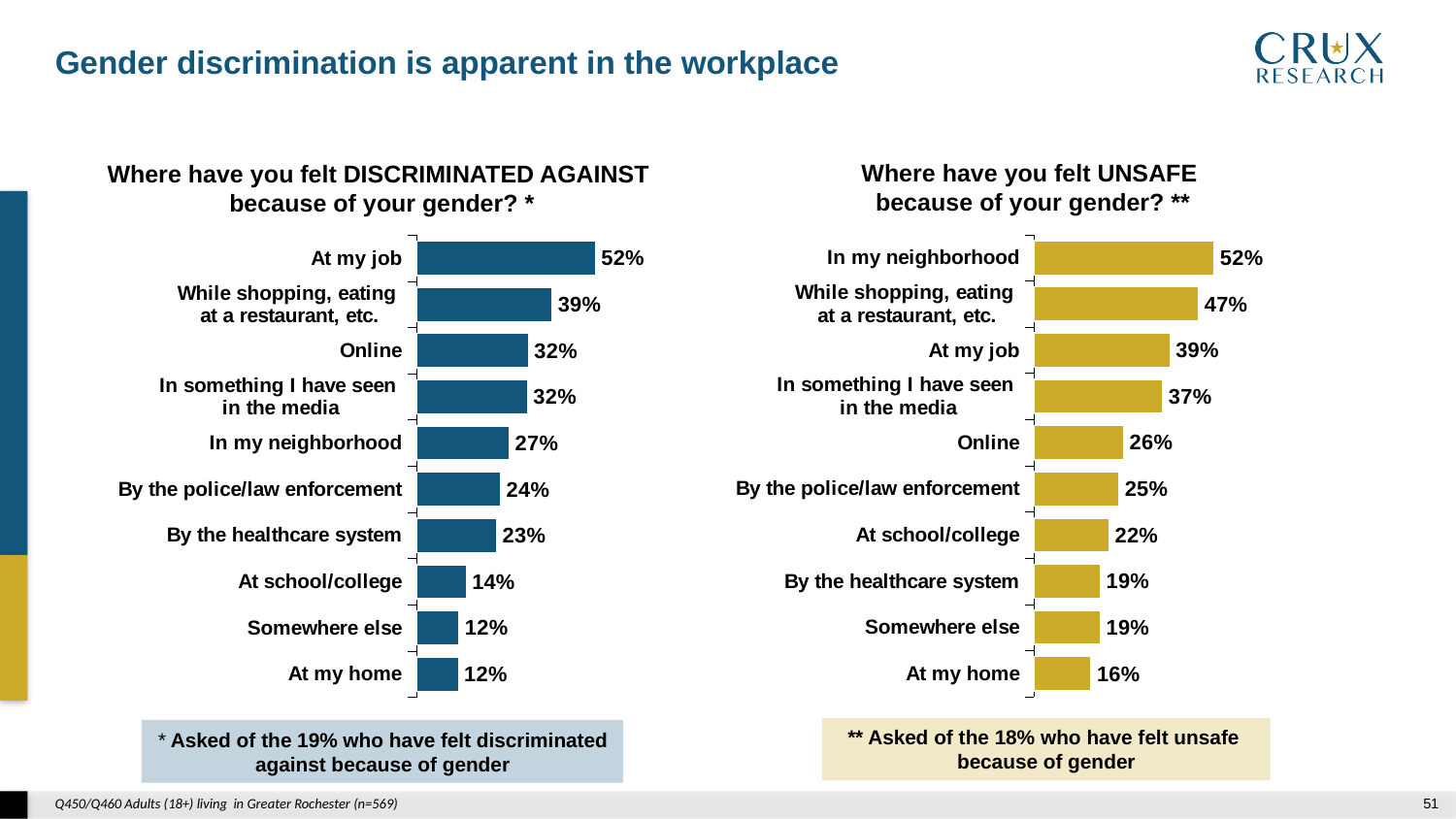
What colour are the bars in the 'Where have you felt DISCRIMINATED AGAINST because of your gender?' chart? Blue In the 'Where have you felt DISCRIMINATED AGAINST because of your gender?' chart, what is the difference between 'At my job' and 'While shopping, eating at a restaurant, etc.'? 13 percentage points What type of chart is used for 'Where have you felt UNSAFE because of your gender?'? Bar chart In the 'Where have you felt UNSAFE because of your gender?' chart, what is the value for 'In my neighborhood'? 52% In the 'Where have you felt UNSAFE because of your gender?' chart, which category has the highest value? In my neighborhood In the 'Where have you felt UNSAFE because of your gender?' chart, what is the value for 'By the police/law enforcement'? 25% How many categories are shown in the 'Where have you felt DISCRIMINATED AGAINST because of your gender?' chart? 10 Which is larger: 'Online' in the DISCRIMINATED AGAINST chart or 'Online' in the UNSAFE chart? Online in the DISCRIMINATED AGAINST chart (32%) In the 'Where have you felt DISCRIMINATED AGAINST because of your gender?' chart, what is the value for 'At my job'? 52% In the 'Where have you felt UNSAFE because of your gender?' chart, which category has the lowest value? At my home In the 'Where have you felt UNSAFE because of your gender?' chart, what is the difference between 'In my neighborhood' and 'At my job'? 13 percentage points In the 'Where have you felt DISCRIMINATED AGAINST because of your gender?' chart, which category has the lowest value? Somewhere else and At my home (both 12%)